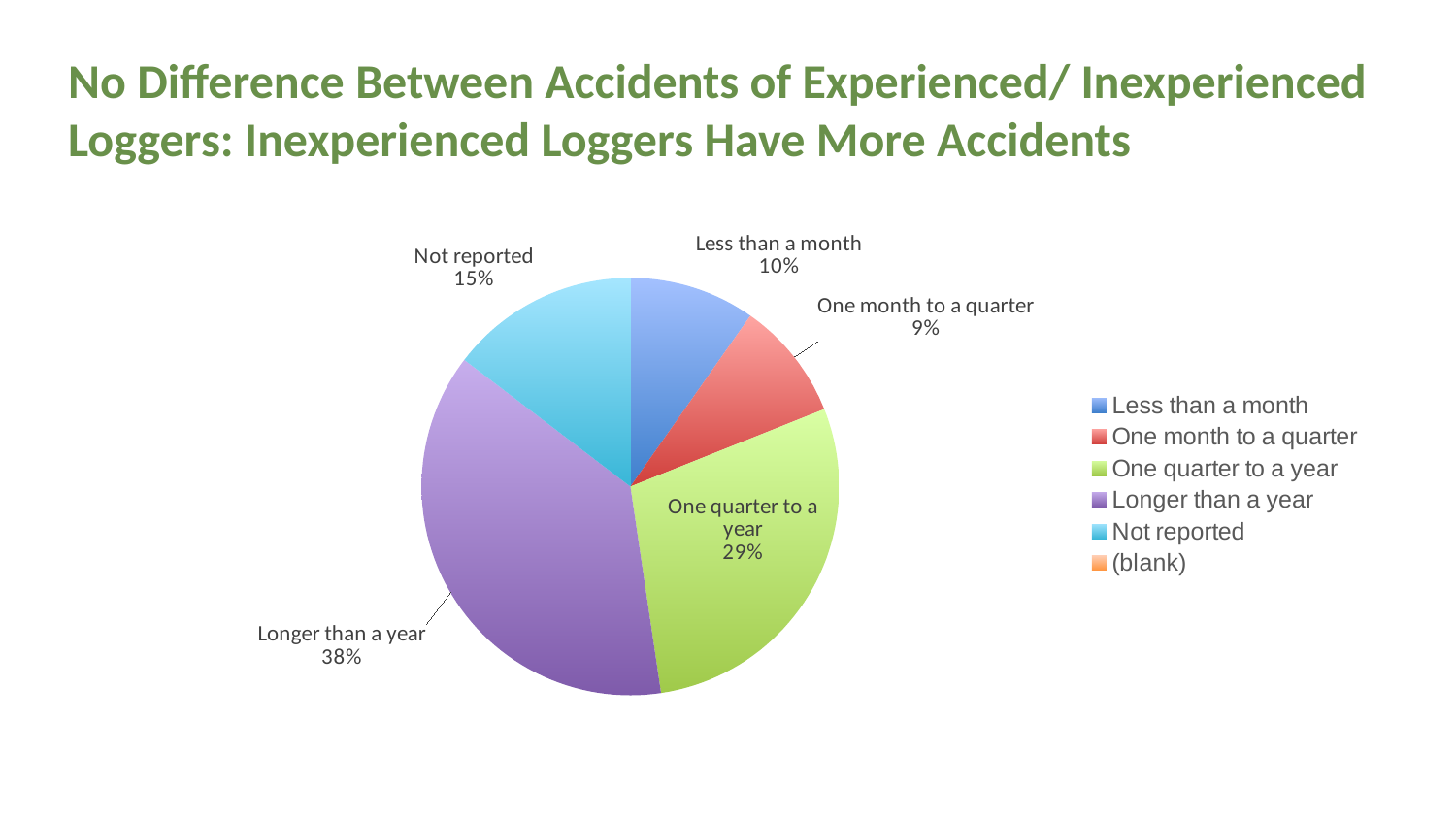
What share of the pie is labelled "One month to a quarter"? 9% What share of the pie is labelled "One quarter to a year"? 29% What kind of chart is shown on the slide? pie chart What share of the pie is labelled "Longer than a year"? 38% What colour is the "Longer than a year" slice? purple Which is larger, the "Not reported" slice or the "Less than a month" slice? Not reported Which slice of the pie is the largest? Longer than a year Which labelled slice of the pie is the smallest? One month to a quarter How many entries does the legend list? 6 What is the difference in percentage points between the "Longer than a year" slice and the "One quarter to a year" slice? 9